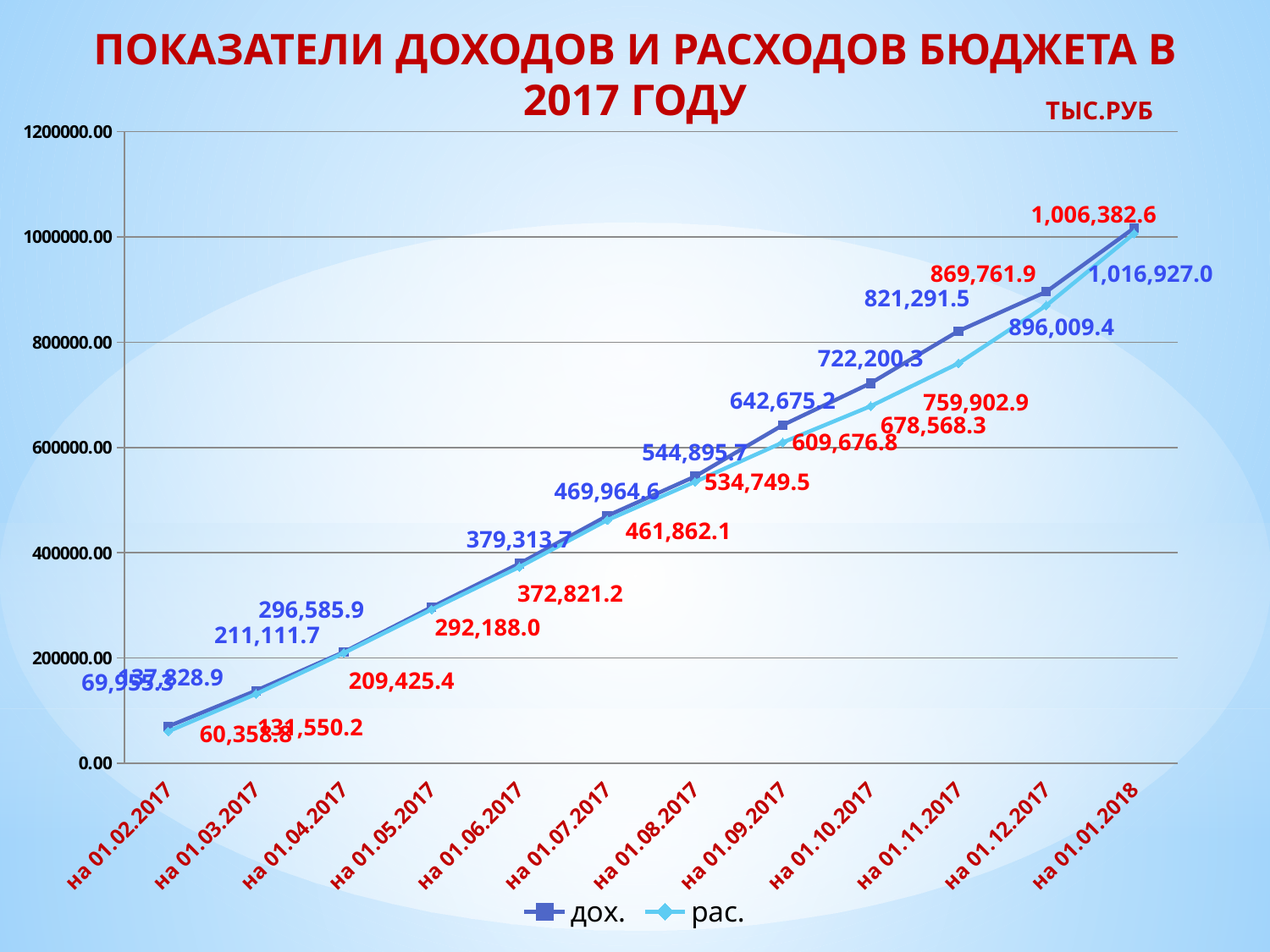
What is the difference between дох. and рас. at на 01.10.2017? 43,632.0 Which series has the larger value at на 01.11.2017, дох. or рас.? дох. How many dates are plotted along the x axis? 12 What is the value of the рас. series at на 01.12.2017? 869,761.9 What is the value of the дох. series at на 01.09.2017? 642,675.2 How many series does the legend list? 2 What is the value of the рас. series at на 01.10.2017? 678,568.3 What type of chart is shown on the slide? line chart At which date does the дох. series reach its highest value? на 01.01.2018 What is the value of the дох. series at на 01.01.2018? 1,016,927.0 At which date is the рас. series at its lowest value? на 01.02.2017 Do the values of the дох. series rise or fall from на 01.02.2017 to на 01.01.2018? rise